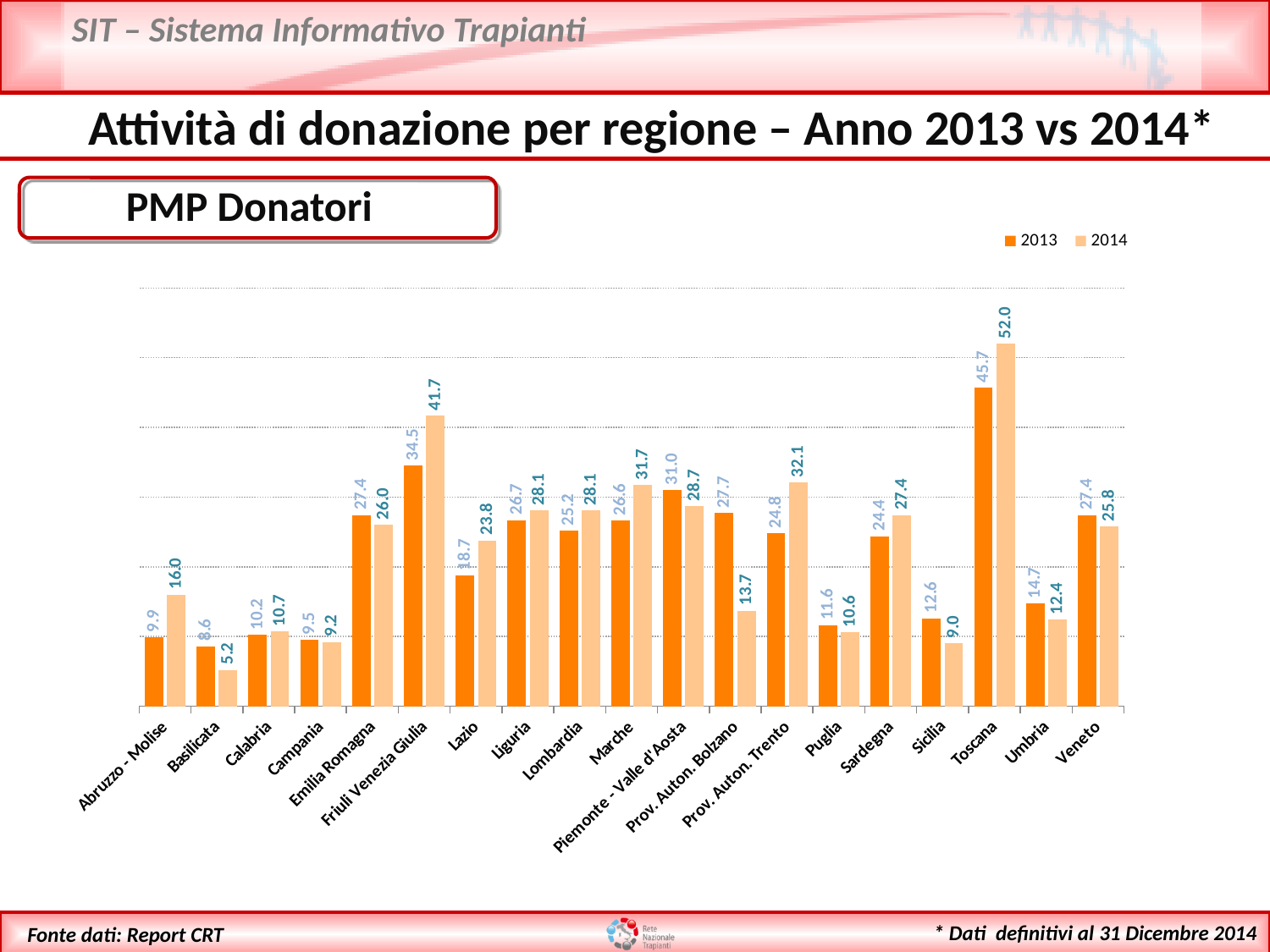
What kind of chart is shown on the slide? Bar chart For Lazio, which year has the larger value, 2013 or 2014? 2014 What is the 2014 value for Toscana? 52.0 What is the 2014 value for Prov. Auton. Bolzano? 13.7 Which region has the highest 2013 value? Toscana What is the 2013 value for Friuli Venezia Giulia? 34.5 What is the difference between the 2014 and 2013 values for Abruzzo - Molise? 6.1 Which region has the lowest 2014 value? Basilicata For Piemonte - Valle d'Aosta, which year has the larger value, 2013 or 2014? 2013 How many series does the legend list? 2 What is the difference between the 2013 and 2014 values for Prov. Auton. Bolzano? 14.0 How many regions are shown on the x axis? 19